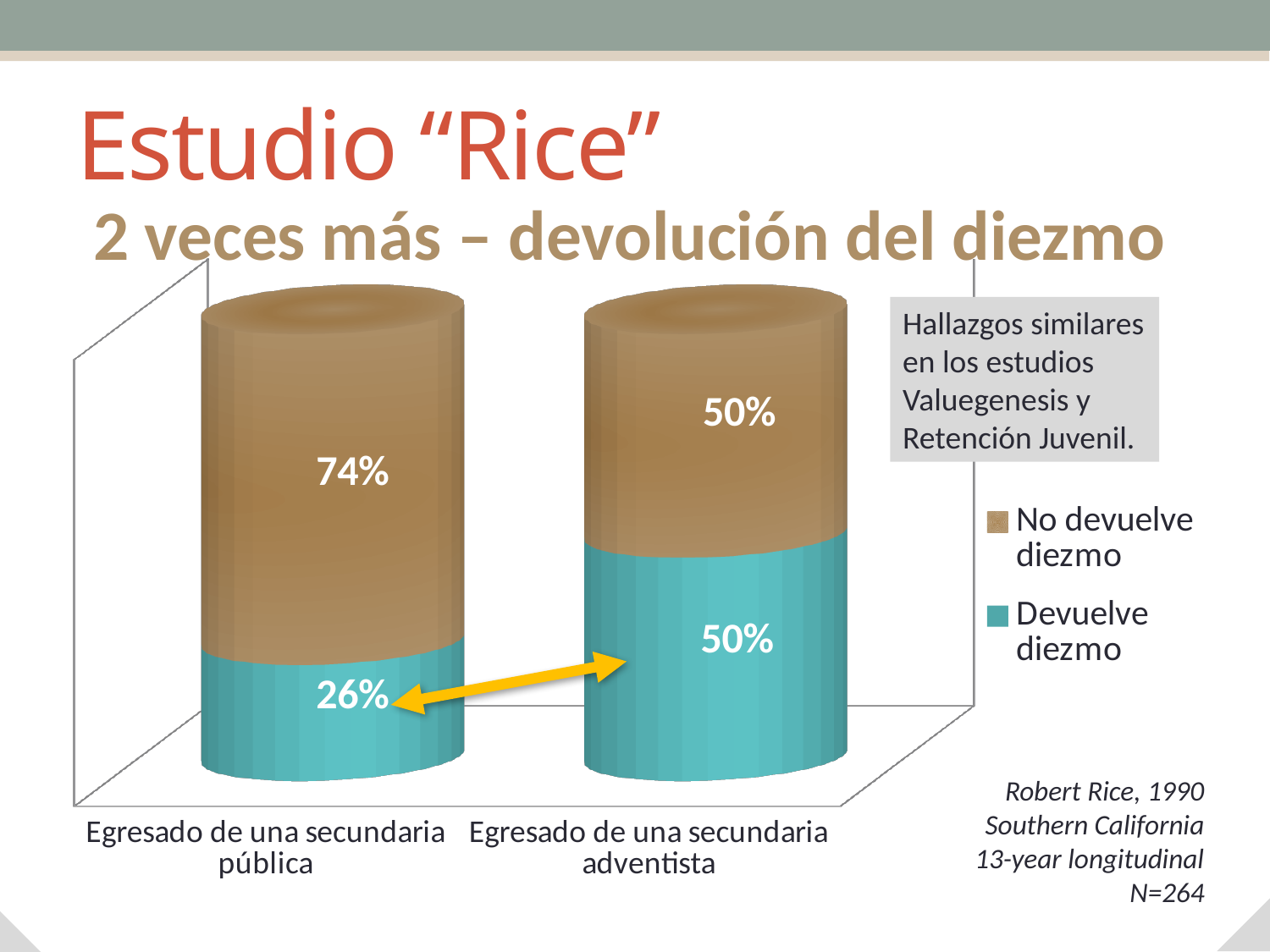
What percentage of graduates from an Adventist secondary school do not return tithe (No devuelve diezmo)? 50% What is the difference between 'No devuelve diezmo' and 'Devuelve diezmo' for public secondary graduates? 48% What percentage of graduates from a public secondary school do not return tithe (No devuelve diezmo)? 74% Is the 'No devuelve diezmo' value for public secondary graduates larger or smaller than the 'No devuelve diezmo' value for Adventist secondary graduates? larger What is the difference in the 'Devuelve diezmo' percentage between Adventist secondary graduates and public secondary graduates? 24% What percentage of graduates from an Adventist secondary school (Egresado de una secundaria adventista) return tithe (Devuelve diezmo)? 50% What percentage of graduates from a public secondary school (Egresado de una secundaria pública) return tithe (Devuelve diezmo)? 26% How many categories are shown on the x axis of the chart? 2 What kind of chart is shown on the slide? Stacked bar chart Which category has the higher share of 'Devuelve diezmo'? Egresado de una secundaria adventista How many series does the legend list? 2 Which category has the lower share of 'Devuelve diezmo'? Egresado de una secundaria pública